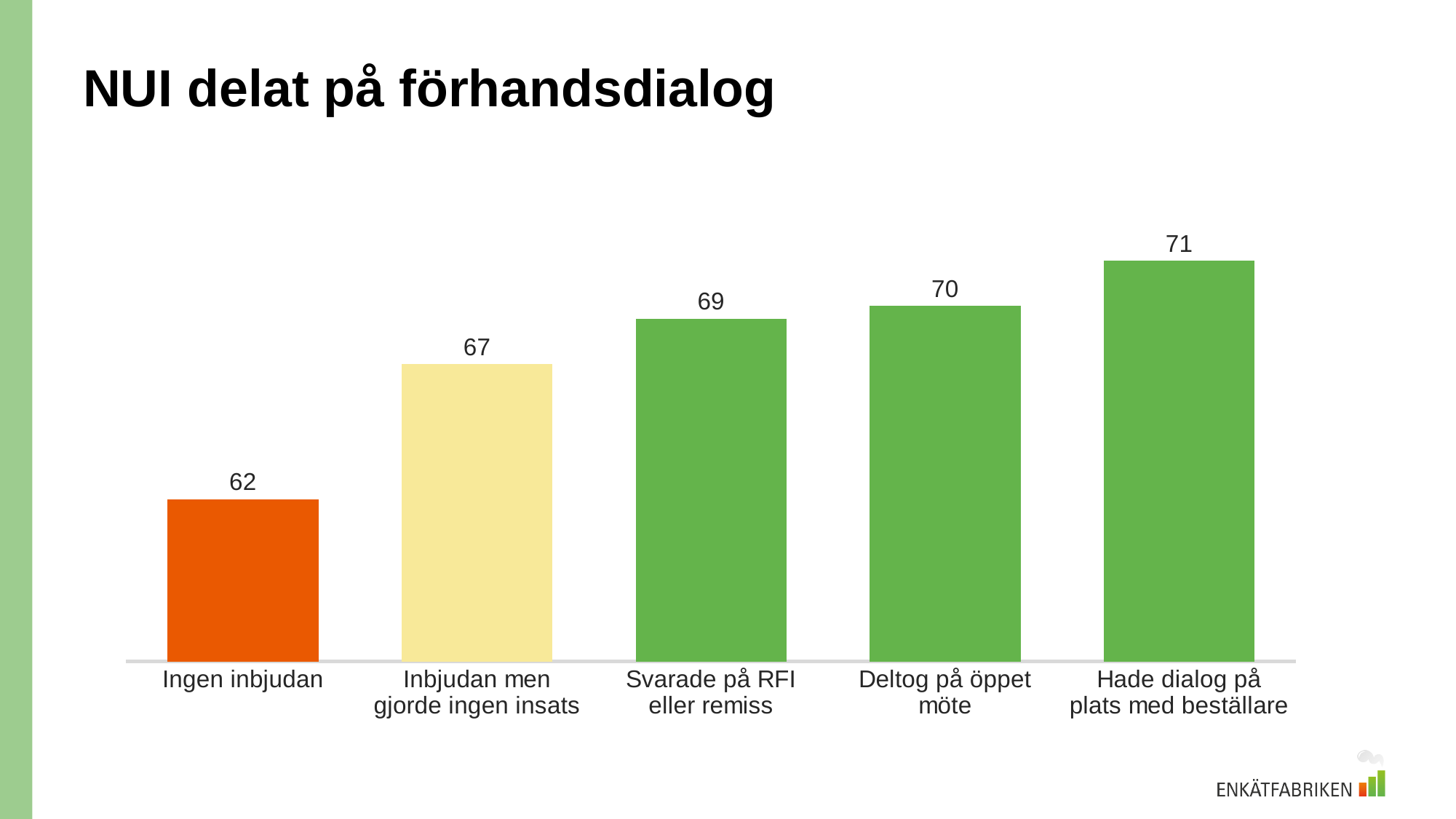
What kind of chart is shown on the slide? Bar chart What is the value for "Svarade på RFI eller remiss"? 69 What is the difference between the values for "Deltog på öppet möte" and "Inbjudan men gjorde ingen insats"? 3 How many categories are shown in the chart? 5 Which is larger, the value for "Ingen inbjudan" or the value for "Svarade på RFI eller remiss"? Svarade på RFI eller remiss What is the difference between the values for "Hade dialog på plats med beställare" and "Ingen inbjudan"? 9 Which category has the lowest value? Ingen inbjudan What is the value for "Ingen inbjudan"? 62 Which category has the highest value? Hade dialog på plats med beställare What is the value for "Inbjudan men gjorde ingen insats"? 67 Do the values rise or fall from left to right along the x axis? Rise What is the value for "Hade dialog på plats med beställare"? 71